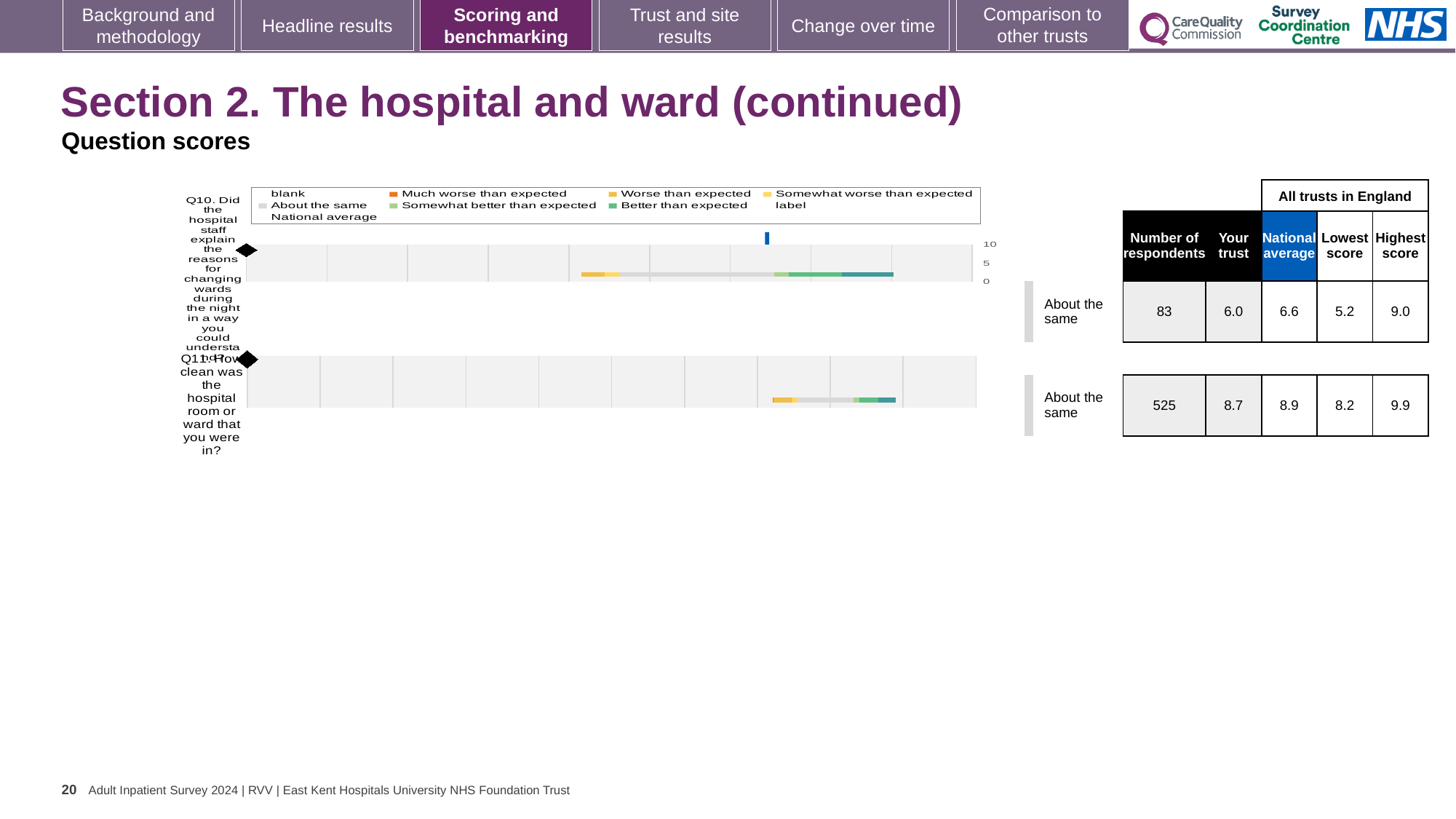
What is the 'Your trust' score for Q10 (Did the hospital staff explain the reasons for changing wards during the night)? 6.0 How many respondents answered Q11? 525 What kind of chart is used to show the question scores for Q10 and Q11? bar chart What is the national average score for Q11? 8.9 Which question has the higher 'Your trust' score, Q10 or Q11? Q11 What benchmark category is shown for Q10? About the same What is the 'Your trust' score for Q11 (How clean was the hospital room or ward that you were in?)? 8.7 What is the difference between the national average and the trust score for Q10? 0.6 How many questions (Q10 and Q11) are plotted on the slide? 2 What is the national average score for Q10? 6.6 What is the highest score across all trusts in England for Q11? 9.9 What is the maximum value shown on the score axis of the charts? 10